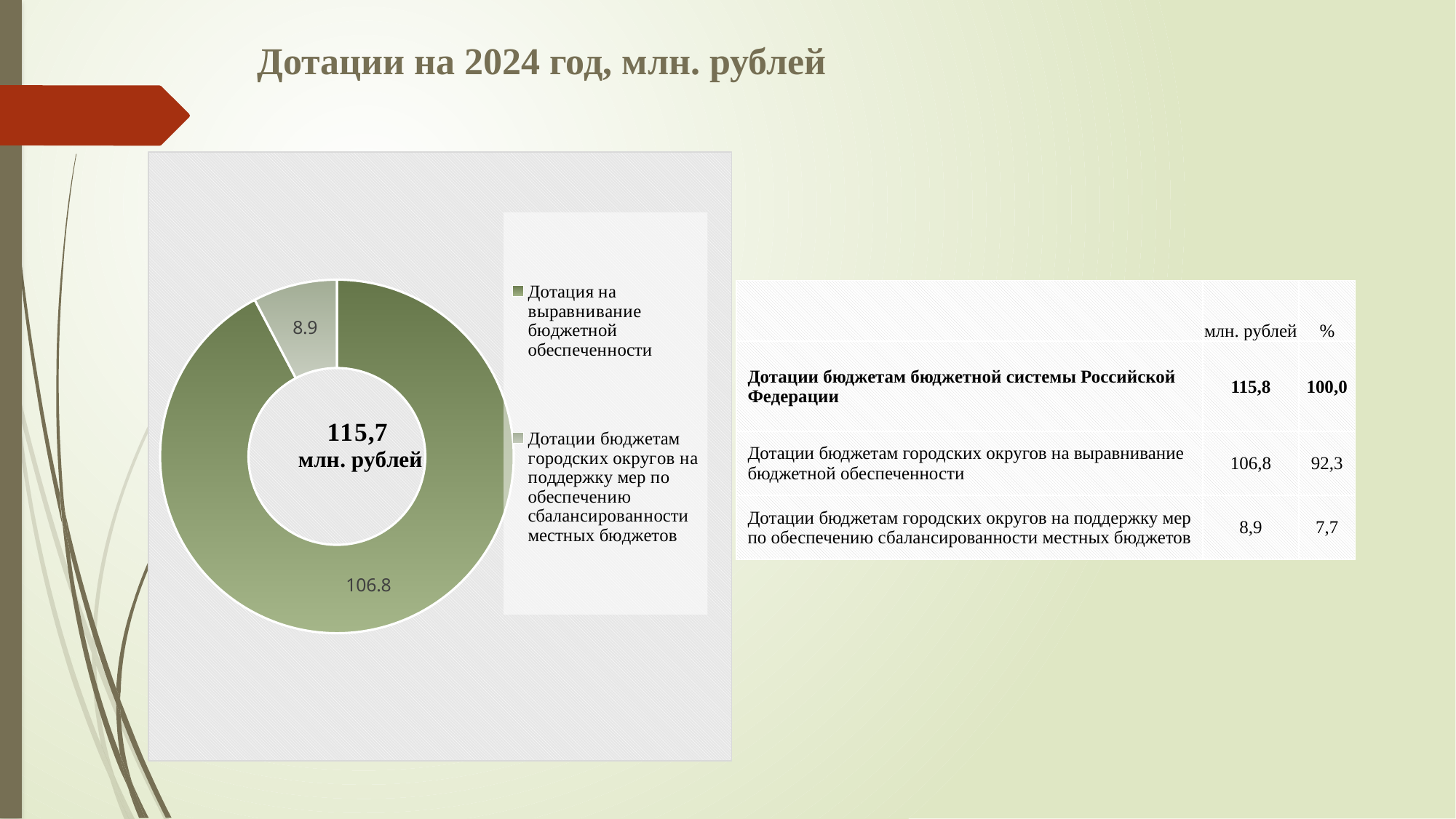
How many entries does the chart legend list? 2 What total value is printed in the centre of the doughnut chart? 115,7 млн. рублей Which slice of the doughnut chart is the smallest? Дотации бюджетам городских округов на поддержку мер по обеспечению сбалансированности местных бюджетов What is the title of the slide containing the chart? Дотации на 2024 год, млн. рублей What is the difference between the two slice values in the doughnut chart (106.8 and 8.9)? 97.9 Which is larger: the slice for 'Дотация на выравнивание бюджетной обеспеченности' or the slice for 'Дотации бюджетам городских округов на поддержку мер по обеспечению сбалансированности местных бюджетов'? Дотация на выравнивание бюджетной обеспеченности Which slice of the doughnut chart is the largest? Дотация на выравнивание бюджетной обеспеченности What value is shown for the slice 'Дотация на выравнивание бюджетной обеспеченности'? 106.8 What share of the total does the slice with value 8.9 represent, according to the slide? 7,7% How many slices does the doughnut chart have? 2 What type of chart is shown on the slide? Doughnut (pie) chart What value is shown for the slice 'Дотации бюджетам городских округов на поддержку мер по обеспечению сбалансированности местных бюджетов'? 8.9